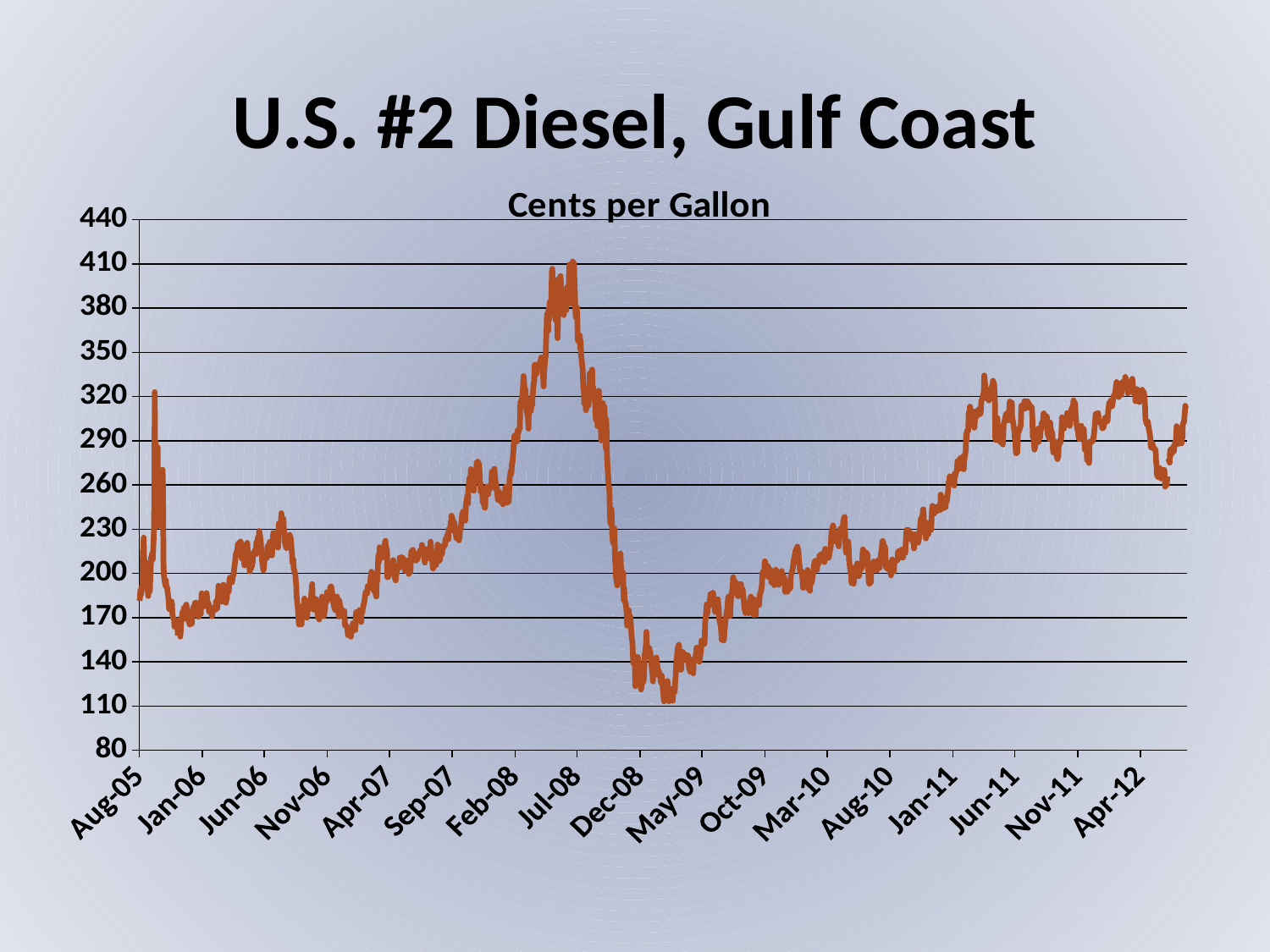
Does the line rise or fall between Jul-08 and Dec-08? fall Is the value around Jan-11 greater or less than 230? greater Near which labeled month on the x axis does the line reach its highest point? Jul-08 Does the line rise or fall between May-09 and Jun-11? rise Is the peak value of the line around Jul-08 greater or less than 380? greater Is the value around May-09 greater or less than 170? less What kind of chart is shown on the slide? line chart Which is higher, the value around Jul-08 or the value around Apr-12? Jul-08 What unit is the vertical axis measured in, according to the chart subtitle? Cents per Gallon What is the title of the chart? U.S. #2 Diesel, Gulf Coast